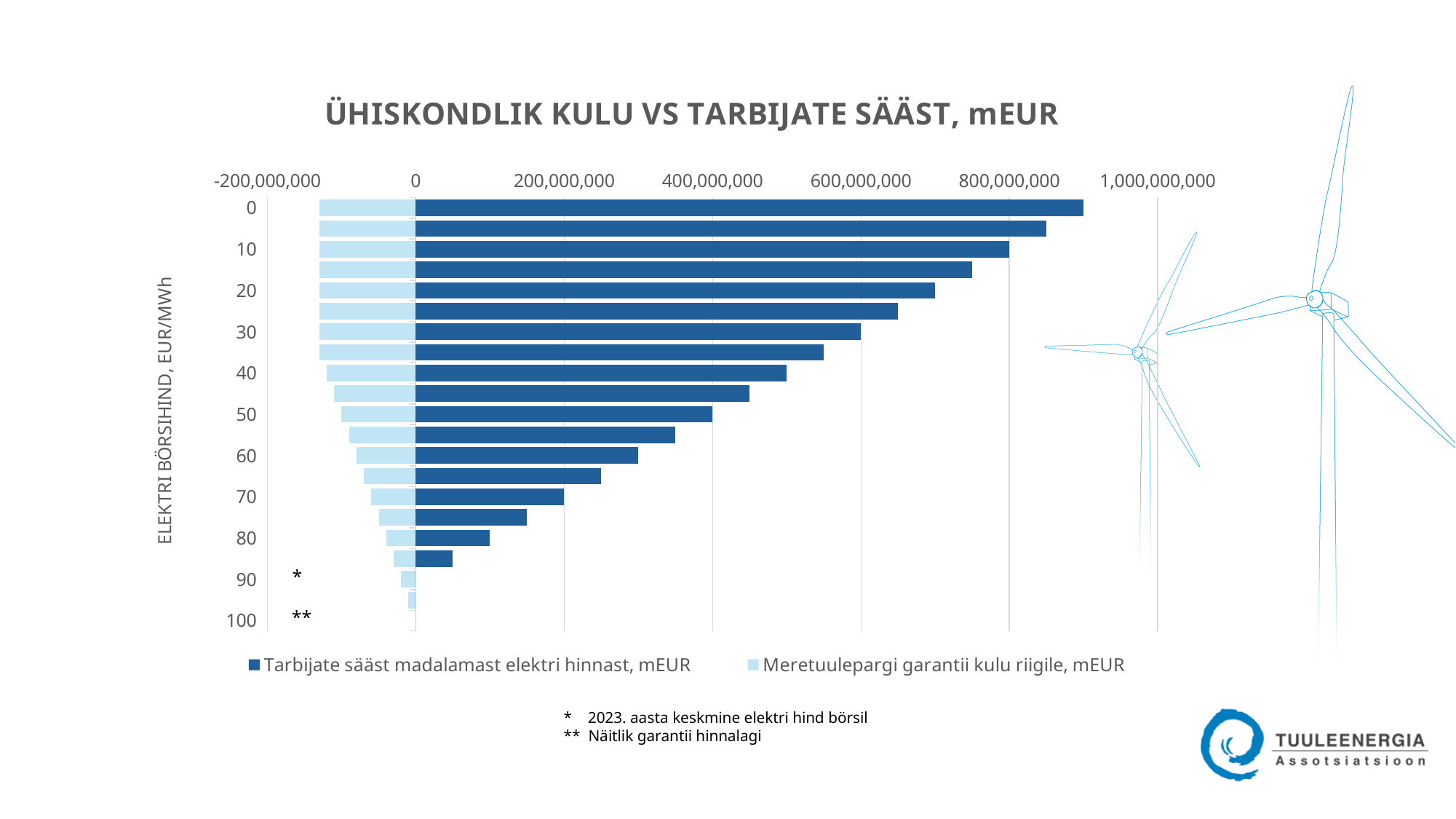
Is the value of 'Tarbijate sääst madalamast elektri hinnast, mEUR' at electricity price 40 greater or less than 400,000,000? greater What kind of chart is shown on the slide? bar chart Is the value of 'Tarbijate sääst madalamast elektri hinnast, mEUR' at electricity price 60 greater or less than 400,000,000? less Is the value of 'Tarbijate sääst madalamast elektri hinnast, mEUR' at electricity price 0 greater or less than 800,000,000? greater What is the title of the chart? ÜHISKONDLIK KULU VS TARBIJATE SÄÄST, mEUR At which electricity price is 'Tarbijate sääst madalamast elektri hinnast, mEUR' highest? 0 Do the values of 'Tarbijate sääst madalamast elektri hinnast, mEUR' rise or fall as the electricity price increases from 0 to 100? fall Which is larger for 'Tarbijate sääst madalamast elektri hinnast, mEUR': the value at electricity price 20 or at 60? 20 How many series does the legend list? 2 What is the label of the vertical axis? ELEKTRI BÖRSIHIND, EUR/MWh